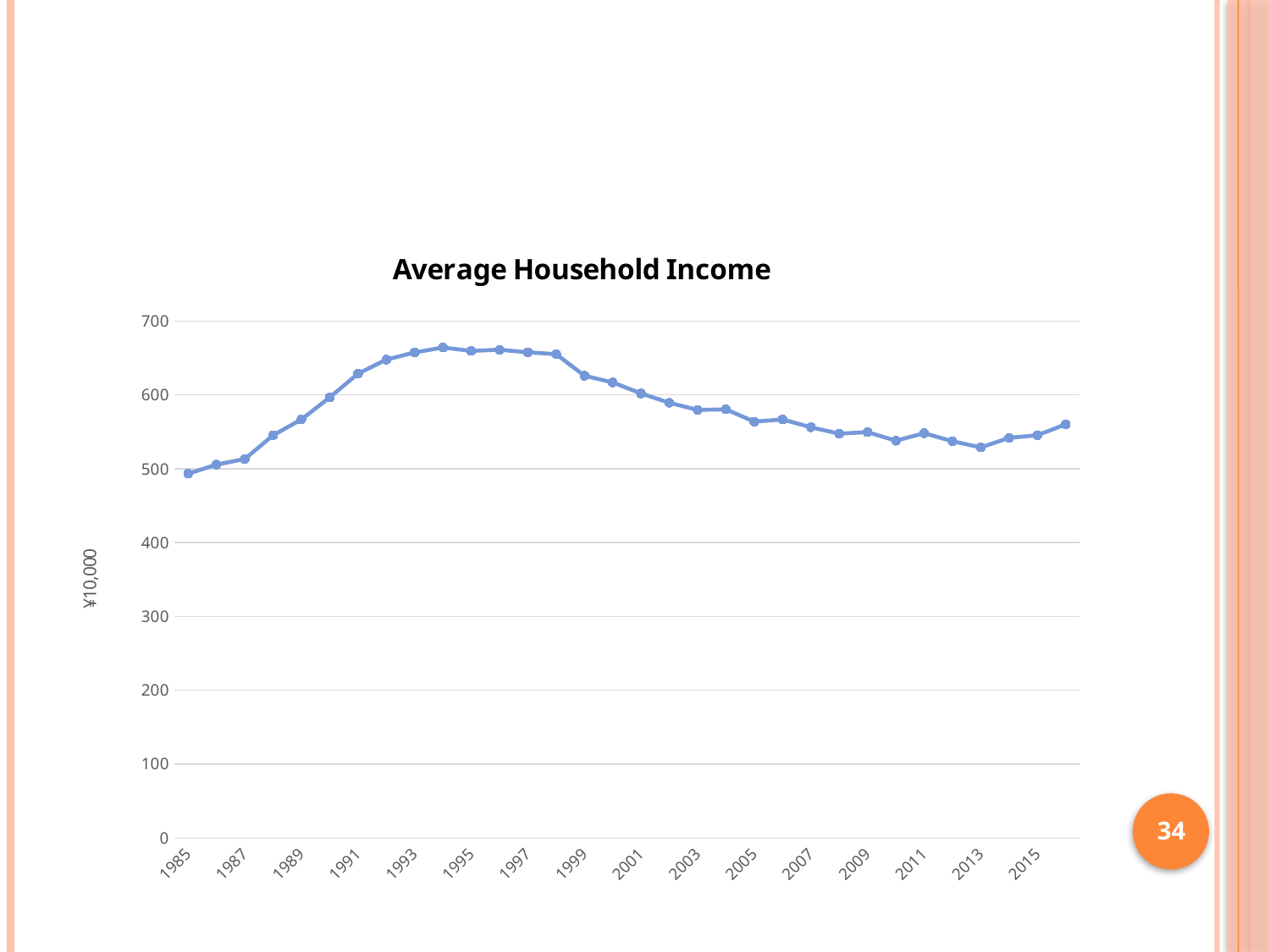
Do the values rise or fall between 1997 and 2013? fall Is the value for 1994 greater or less than 600? greater What unit label is shown on the vertical axis of the chart? ¥10,000 What kind of chart is shown on the slide? Line chart What is the title of the chart? Average Household Income Is the value for 1985 greater or less than 500? less In which year does the average household income reach its highest point? 1994 In which year is the average household income at its lowest? 1985 Which year has the higher average household income, 1994 or 2013? 1994 Is the value for 2013 greater or less than 500? greater Do the values rise or fall between 1985 and 1994? rise